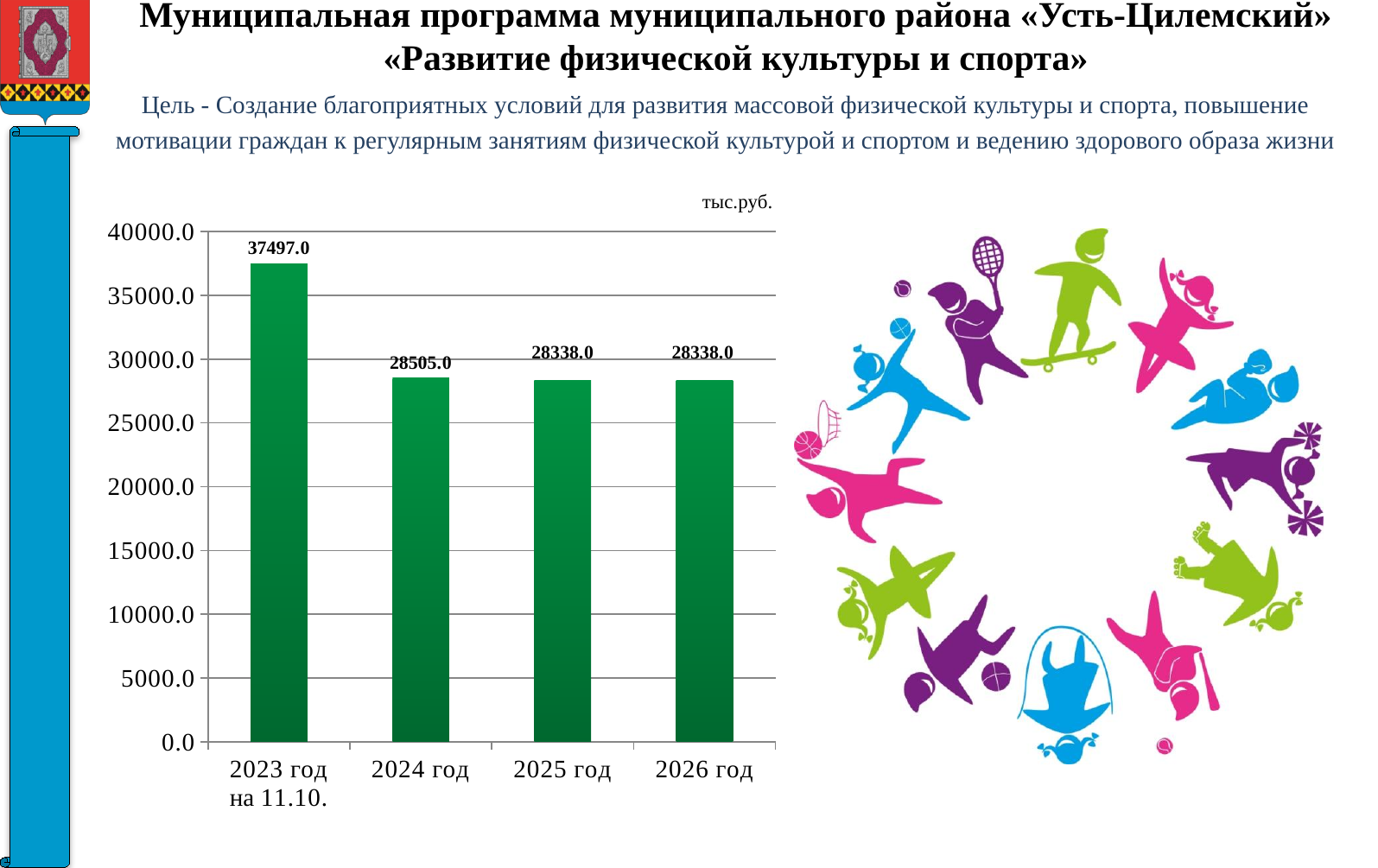
What is the value for 2023 год на 11.10.? 37497.0 Is the value for 2023 год на 11.10. greater or less than 35000.0? greater What is the difference between the values for 2023 год на 11.10. and 2024 год? 8992.0 Which is larger, the value for 2023 год на 11.10. or the value for 2025 год? 2023 год на 11.10. What is the value for 2024 год? 28505.0 Is the value for 2024 год greater or less than 30000.0? less What is the value for 2026 год? 28338.0 How many categories are shown on the x axis? 4 What unit label is shown above the chart? тыс.руб. Which category has the highest value? 2023 год на 11.10. What is the difference between the values for 2024 год and 2025 год? 167.0 What kind of chart is shown on the slide? bar chart